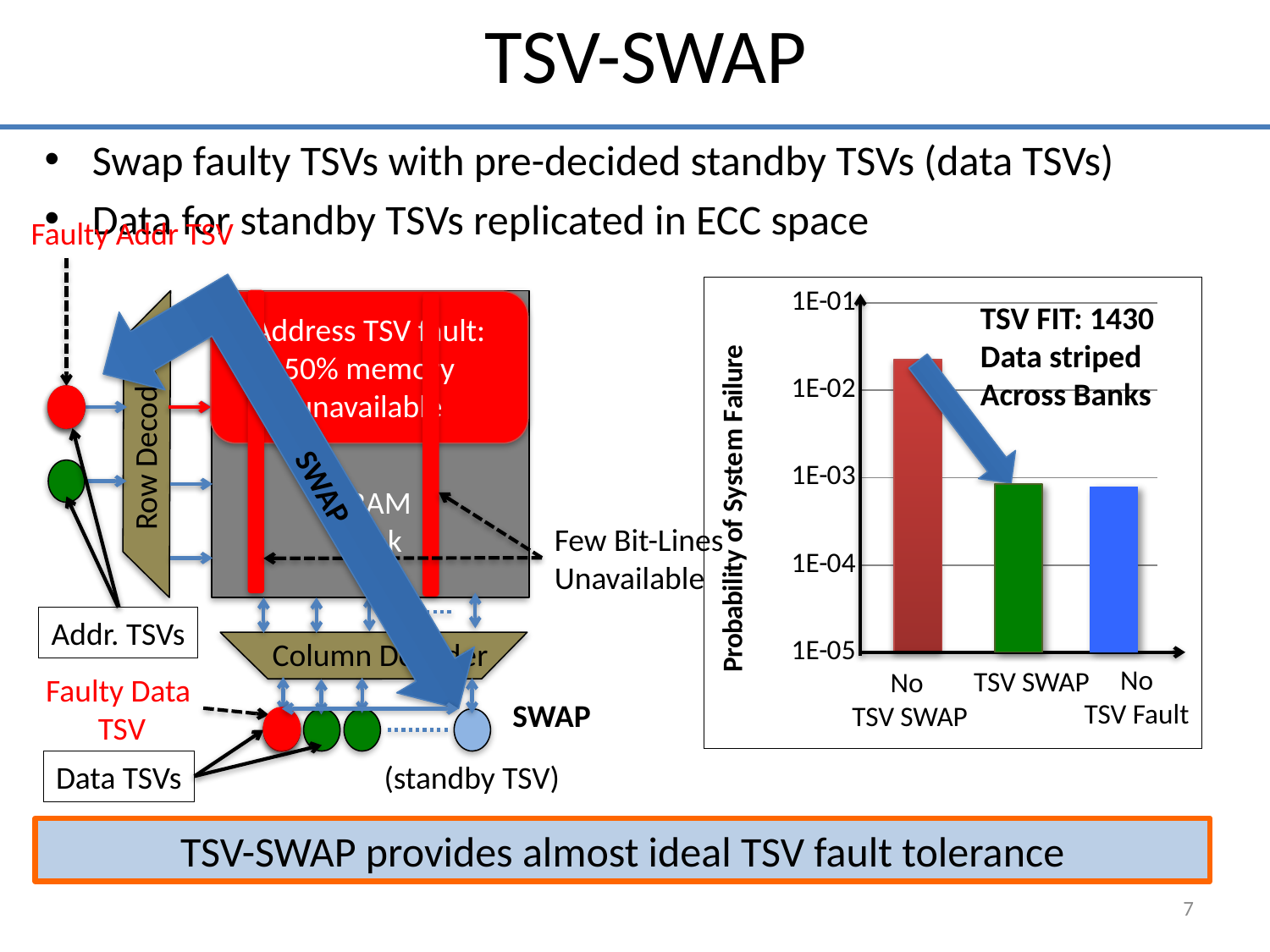
Is the value for No TSV SWAP greater or less than 1E-02? greater What kind of chart is shown on the right side of the slide? bar chart What TSV FIT value is stated in the annotation on the chart? 1430 Is the value for No TSV SWAP greater or less than 1E-01? less Which is larger, the value for No TSV SWAP or the value for TSV SWAP? No TSV SWAP What is the label of the chart's y-axis? Probability of System Failure How many bars (categories) does the chart show? 3 Which category has the highest probability of system failure? No TSV SWAP Which is larger, the value for No TSV SWAP or the value for No TSV Fault? No TSV SWAP